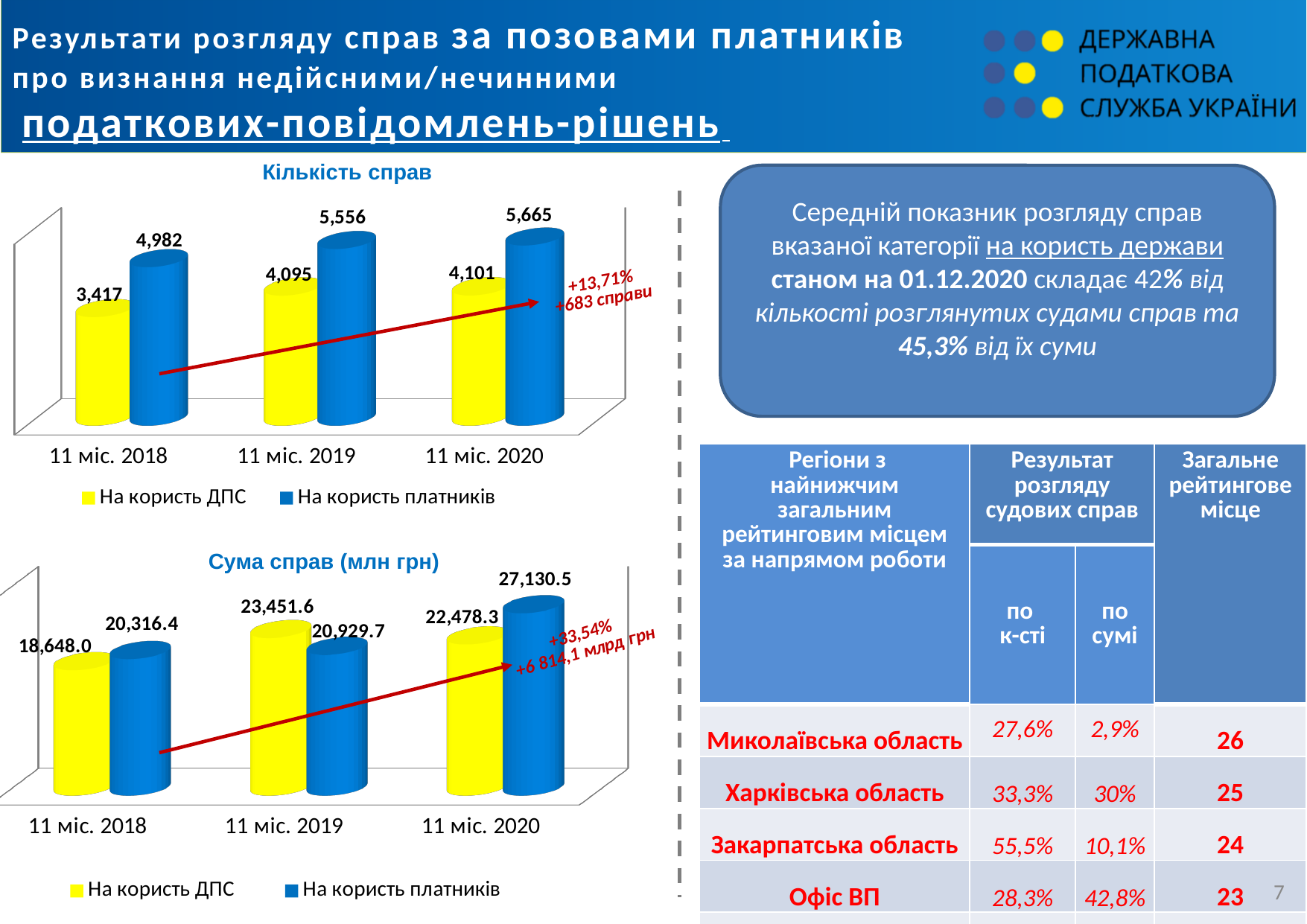
In the 'Сума справ (млн грн)' chart, which period has the lowest value for 'На користь ДПС'? 11 міс. 2018 In the 'Кількість справ' chart, which period has the highest value for 'На користь ДПС'? 11 міс. 2020 In the 'Кількість справ' chart, how many series does the legend list? 2 In the 'Сума справ (млн грн)' chart, what is the value for 'На користь платників' in 11 міс. 2020? 27,130.5 In the 'Сума справ (млн грн)' chart, which is larger in 11 міс. 2019: 'На користь ДПС' or 'На користь платників'? На користь ДПС In the 'Кількість справ' chart, what is the value for 'На користь платників' in 11 міс. 2020? 5,665 What type of chart is the 'Сума справ (млн грн)' chart? bar chart In the 'Кількість справ' chart, what is the difference between 'На користь платників' and 'На користь ДПС' in 11 міс. 2019? 1,461 In the 'Кількість справ' chart, does the value for 'На користь платників' rise or fall from 11 міс. 2018 to 11 міс. 2020? rise In the 'Сума справ (млн грн)' chart, how many periods are shown on the x axis? 3 In the 'Кількість справ' chart, what is the value for 'На користь ДПС' in 11 міс. 2018? 3,417 In the 'Сума справ (млн грн)' chart, what is the value for 'На користь ДПС' in 11 міс. 2019? 23,451.6